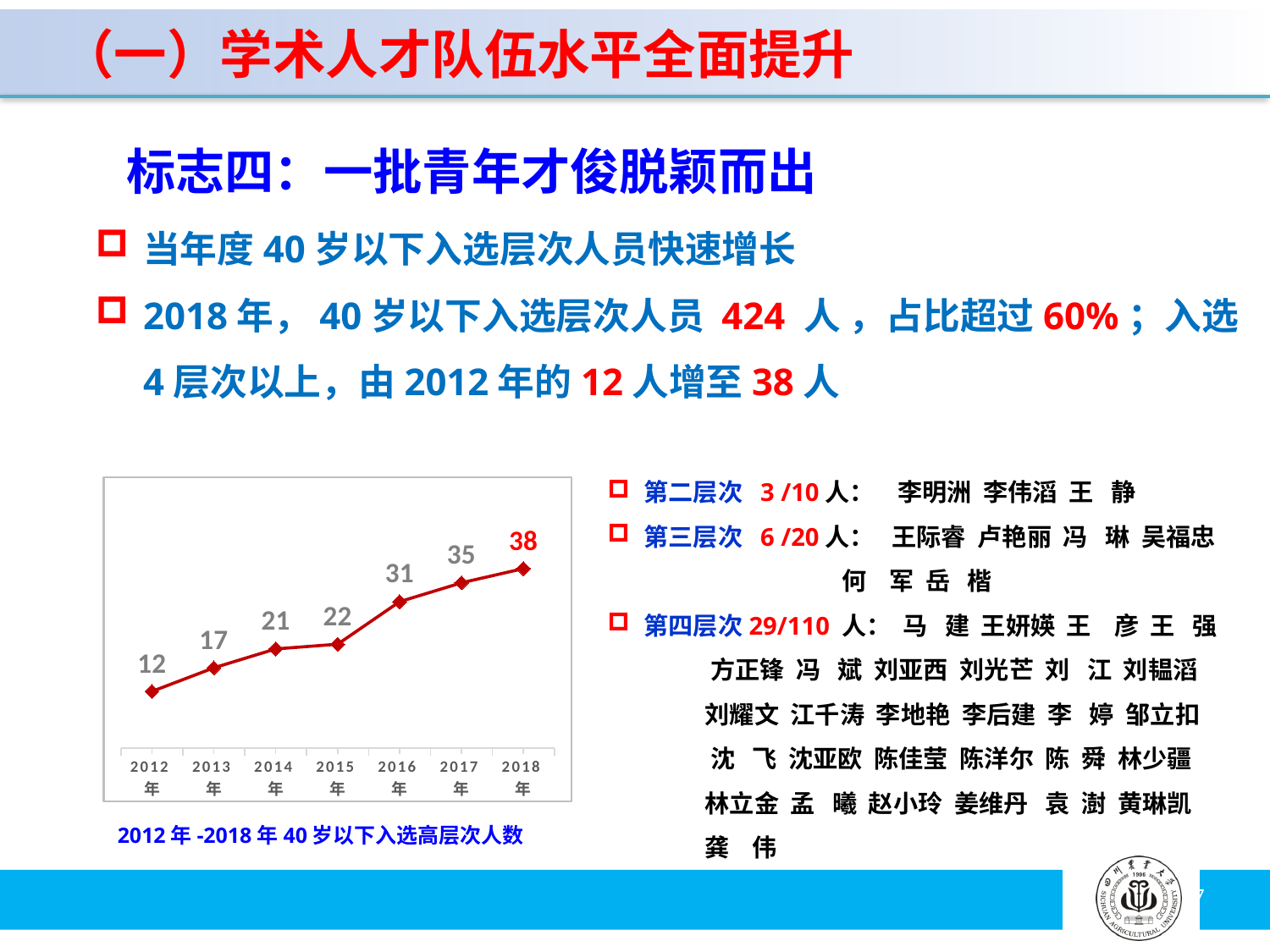
What type of chart is shown on the slide? line chart What is the value for 2018年 in the chart? 38 Do the values rise or fall from 2012年 to 2018年? rise Which is larger, the value for 2013年 or the value for 2017年? 2017年 What is the value for 2014年 in the chart? 21 How many years are plotted on the x axis of the chart? 7 What is the difference between the values for 2016年 and 2015年? 9 Which year has the lowest value in the chart? 2012年 What is the value for 2012年 in the chart? 12 Which year has the highest value in the chart? 2018年 What is the value for 2016年 in the chart? 31 What is the difference between the values for 2018年 and 2012年? 26